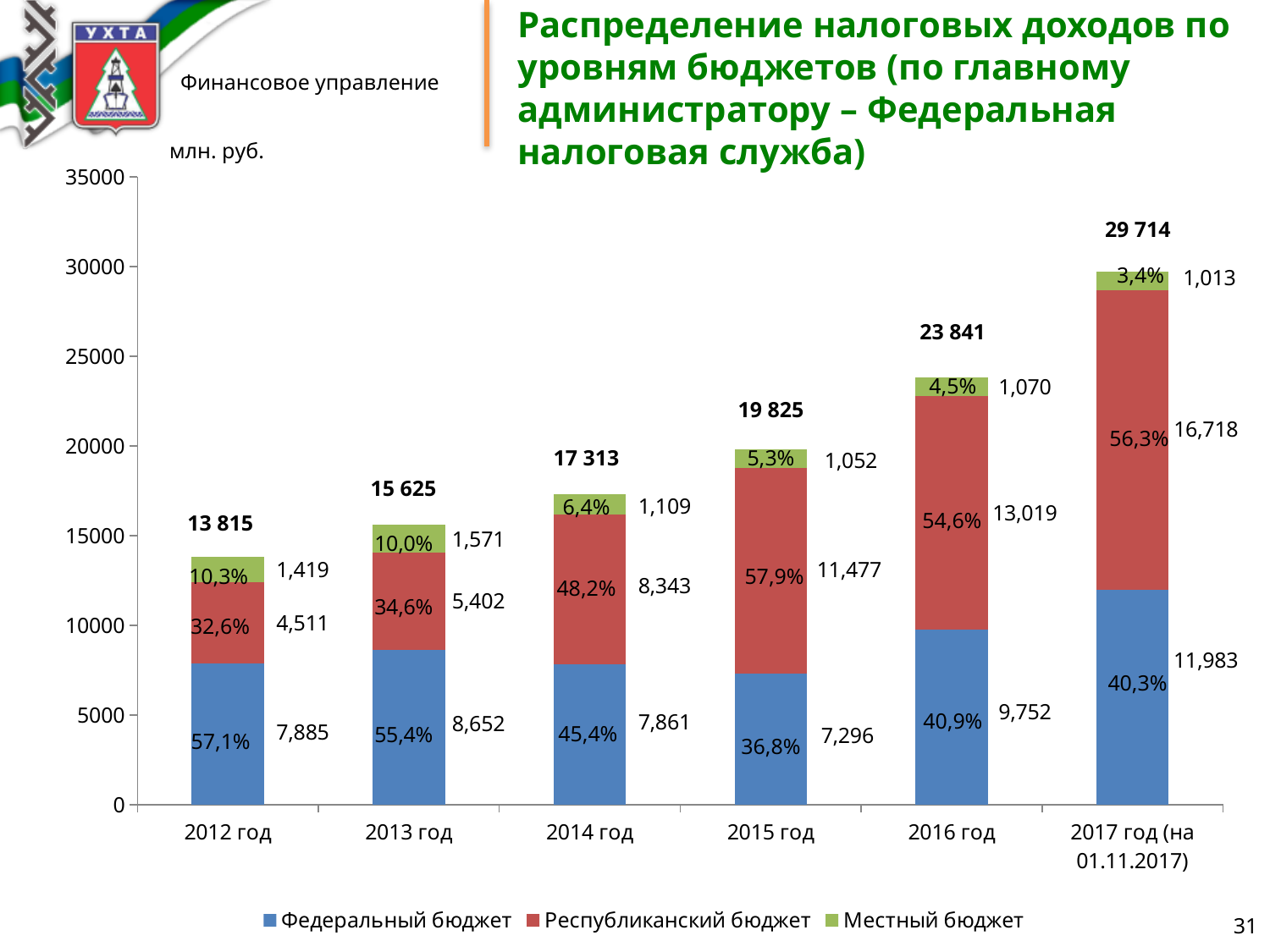
How many series does the legend list? 3 What is the total of the stacked bar for 2015 год? 19 825 Which year has the lowest total tax revenue? 2012 год What is the value for Республиканский бюджет in 2016 год? 13,019 What is the difference between Республиканский бюджет in 2017 год (на 01.11.2017) and in 2016 год? 3,699 What is the value for Федеральный бюджет in 2014 год? 7,861 What percentage share does Федеральный бюджет have in 2012 год? 57,1% Which year has the highest total tax revenue? 2017 год (на 01.11.2017) What is the value for Местный бюджет in 2013 год? 1,571 Do the total values rise or fall from 2012 год to 2017 год? rise How many years (categories) are shown on the x axis? 6 Which is larger, Федеральный бюджет in 2013 год or in 2016 год? 2016 год